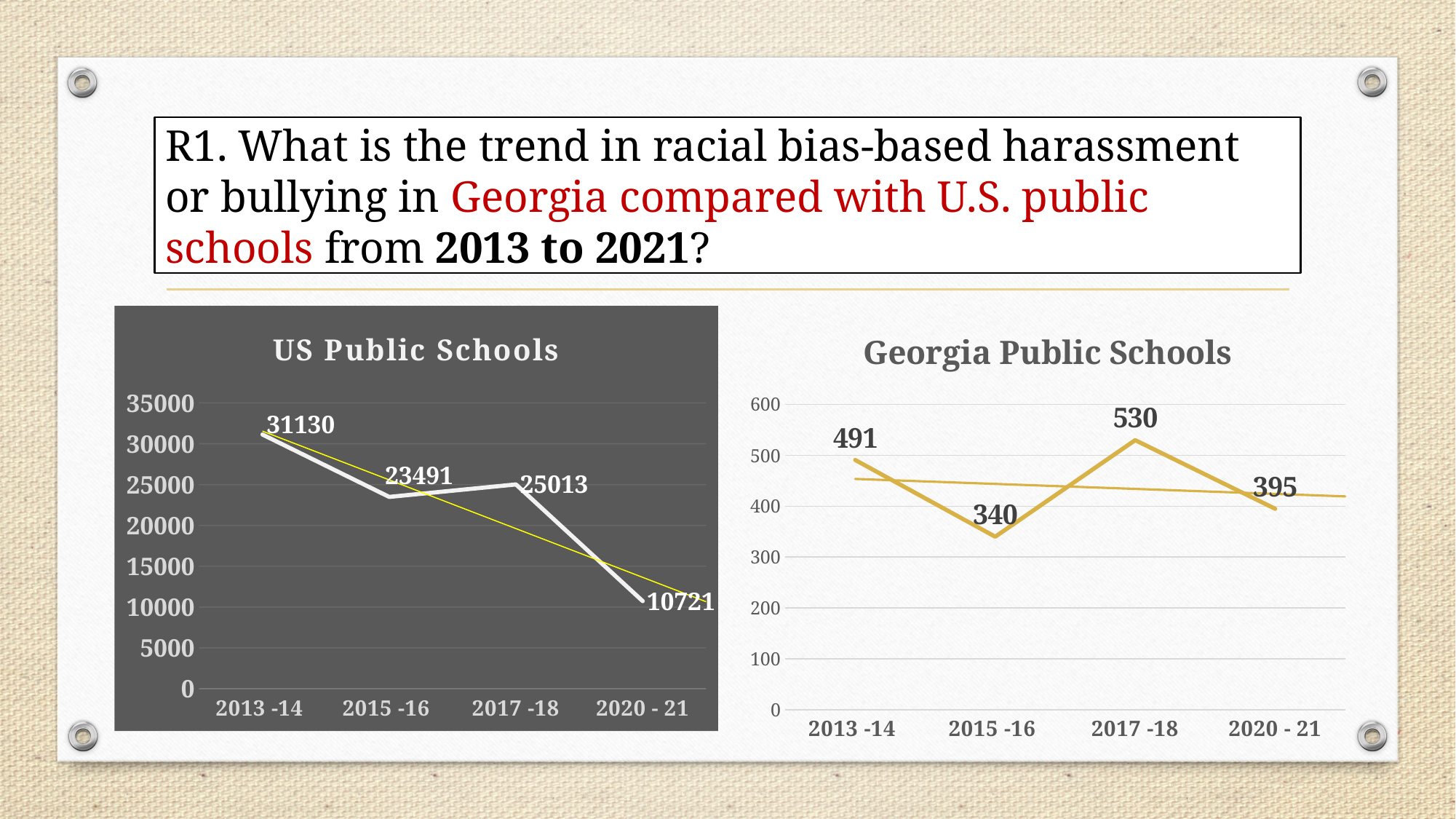
In the Georgia Public Schools chart, which is larger, the value for 2013 -14 or the value for 2020 - 21? 2013 -14 In the US Public Schools chart, what is the value for 2020 - 21? 10721 In the Georgia Public Schools chart, what is the value for 2015 -16? 340 In the US Public Schools chart, what is the difference between the 2017 -18 value and the 2015 -16 value? 1522 In the US Public Schools chart, which period has the highest value? 2013 -14 In the US Public Schools chart, what is the value for 2013 -14? 31130 In the Georgia Public Schools chart, what is the difference between the 2017 -18 value and the 2015 -16 value? 190 In the US Public Schools chart, do the values overall rise or fall from 2013 -14 to 2020 - 21? fall In the Georgia Public Schools chart, which period has the lowest value? 2015 -16 What kind of chart is the Georgia Public Schools chart? line chart How many periods are plotted on the x axis of the US Public Schools chart? 4 In the Georgia Public Schools chart, what is the value for 2017 -18? 530